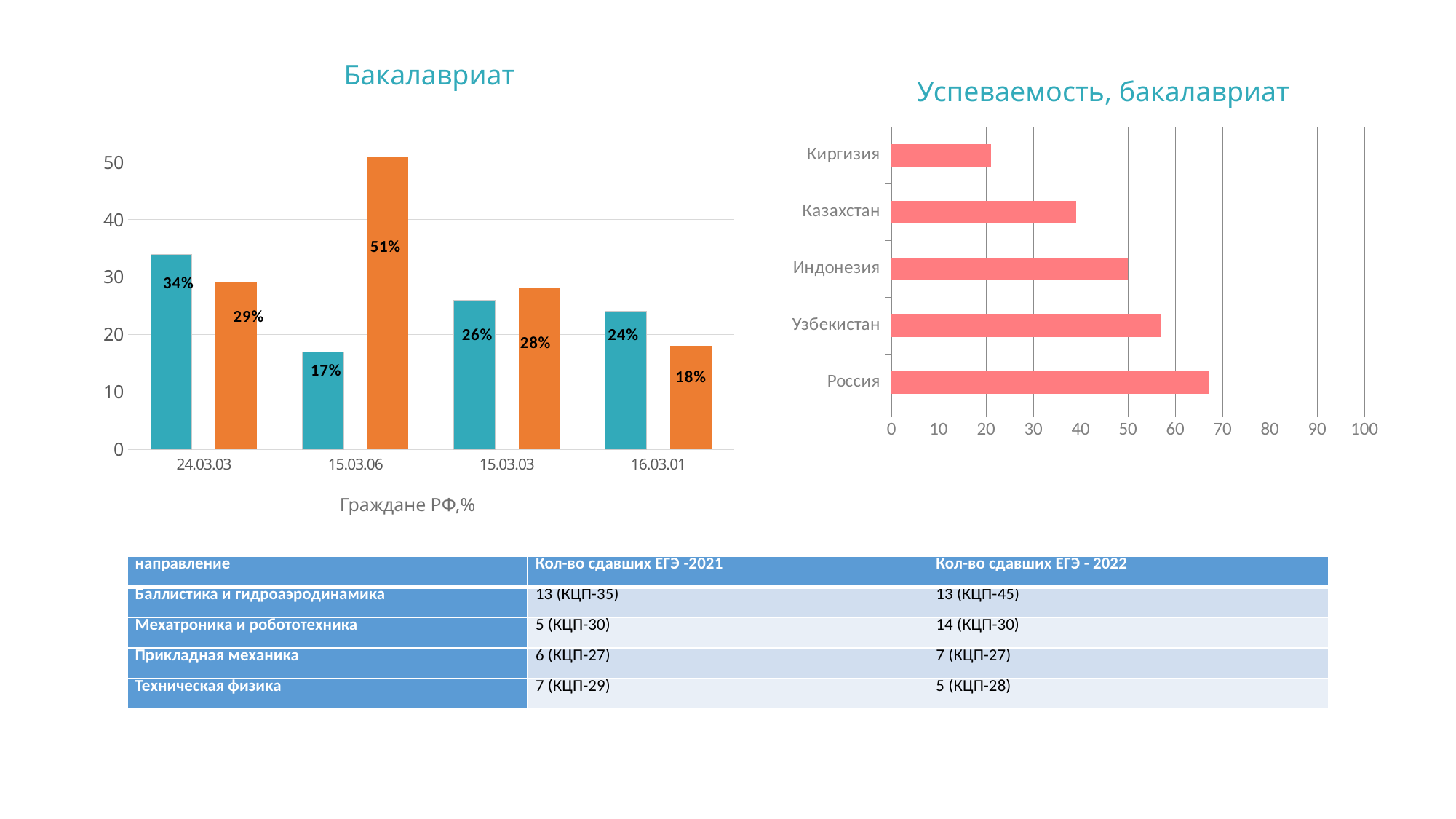
In the chart titled 'Успеваемость, бакалавриат', is the value for Киргизия greater or less than 30? less In the chart titled 'Успеваемость, бакалавриат', which country has the longest bar? Россия In the chart titled 'Успеваемость, бакалавриат', which country has the shortest bar? Киргизия In the chart titled 'Бакалавриат', what value is labelled on the teal bar for 24.03.03? 34% In the chart titled 'Бакалавриат', what value is labelled on the orange bar for 15.03.06? 51% In the chart titled 'Успеваемость, бакалавриат', is the value for Россия greater or less than 60? greater In the chart titled 'Бакалавриат', what is the difference between the orange and teal bars for 15.03.06? 34 percentage points How many categories are shown on the x axis of the chart titled 'Бакалавриат'? 4 What kind of chart is the chart titled 'Успеваемость, бакалавриат'? bar chart In the chart titled 'Бакалавриат', which category has the highest labelled bar? 15.03.06 In the chart titled 'Бакалавриат', what value is labelled on the orange bar for 16.03.01? 18% In the chart titled 'Бакалавриат', which is larger for 15.03.03: the teal bar or the orange bar? the orange bar